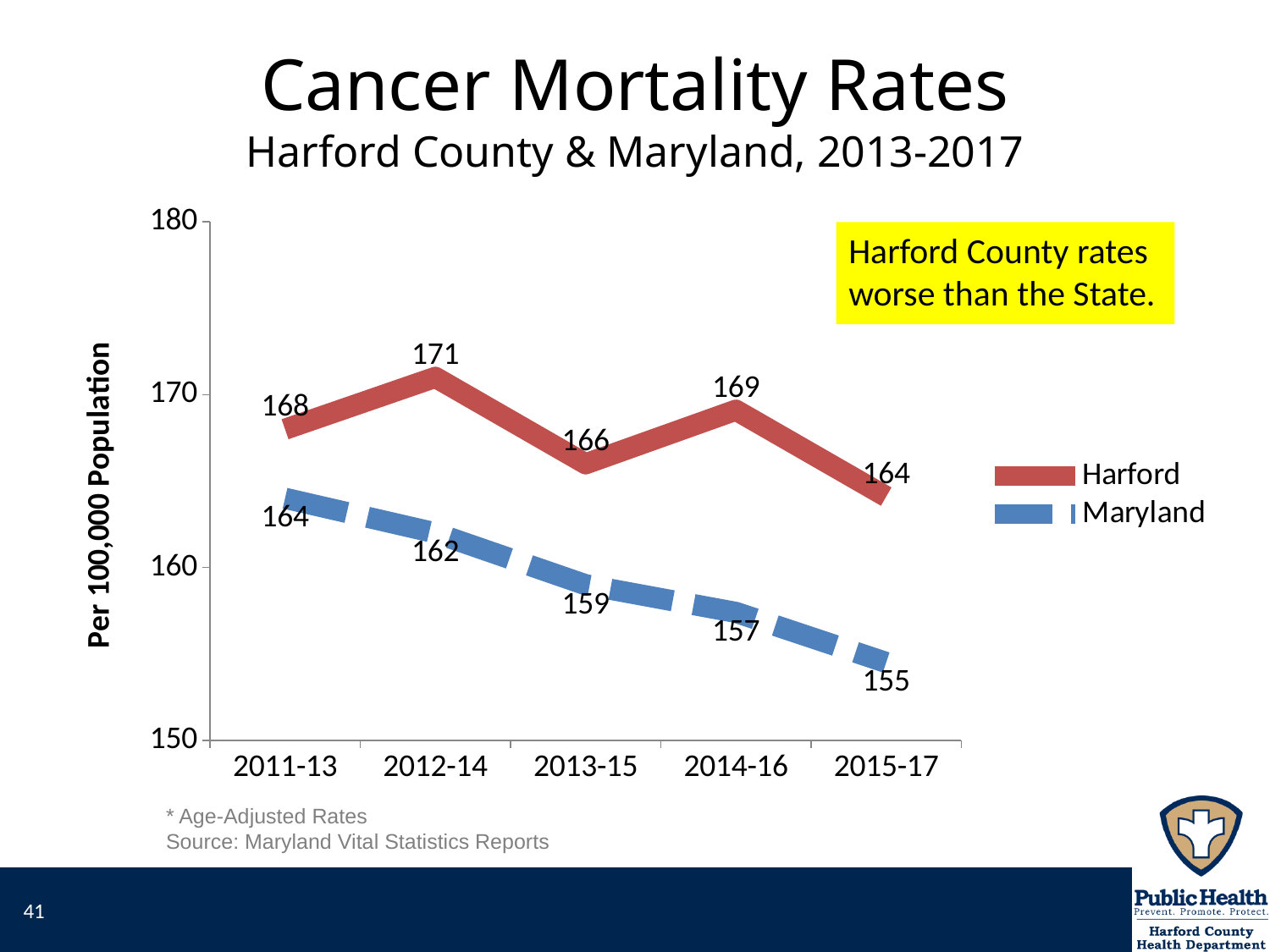
Is the Maryland value for 2014-16 greater or less than 160? less What is the difference between the Harford and Maryland rates in 2015-17? 9 Does the Maryland rate rise or fall from 2011-13 to 2015-17? fall What is the Maryland cancer mortality rate for 2015-17? 155 In which period is the Harford rate highest? 2012-14 In which period is the Maryland rate lowest? 2015-17 How many time periods are shown on the x axis? 5 How many series does the legend list? 2 What kind of chart is shown on the slide? line chart Which is larger in 2013-15, the Harford rate or the Maryland rate? Harford What is the Harford cancer mortality rate for 2012-14? 171 What is the Harford value for 2015-17? 164